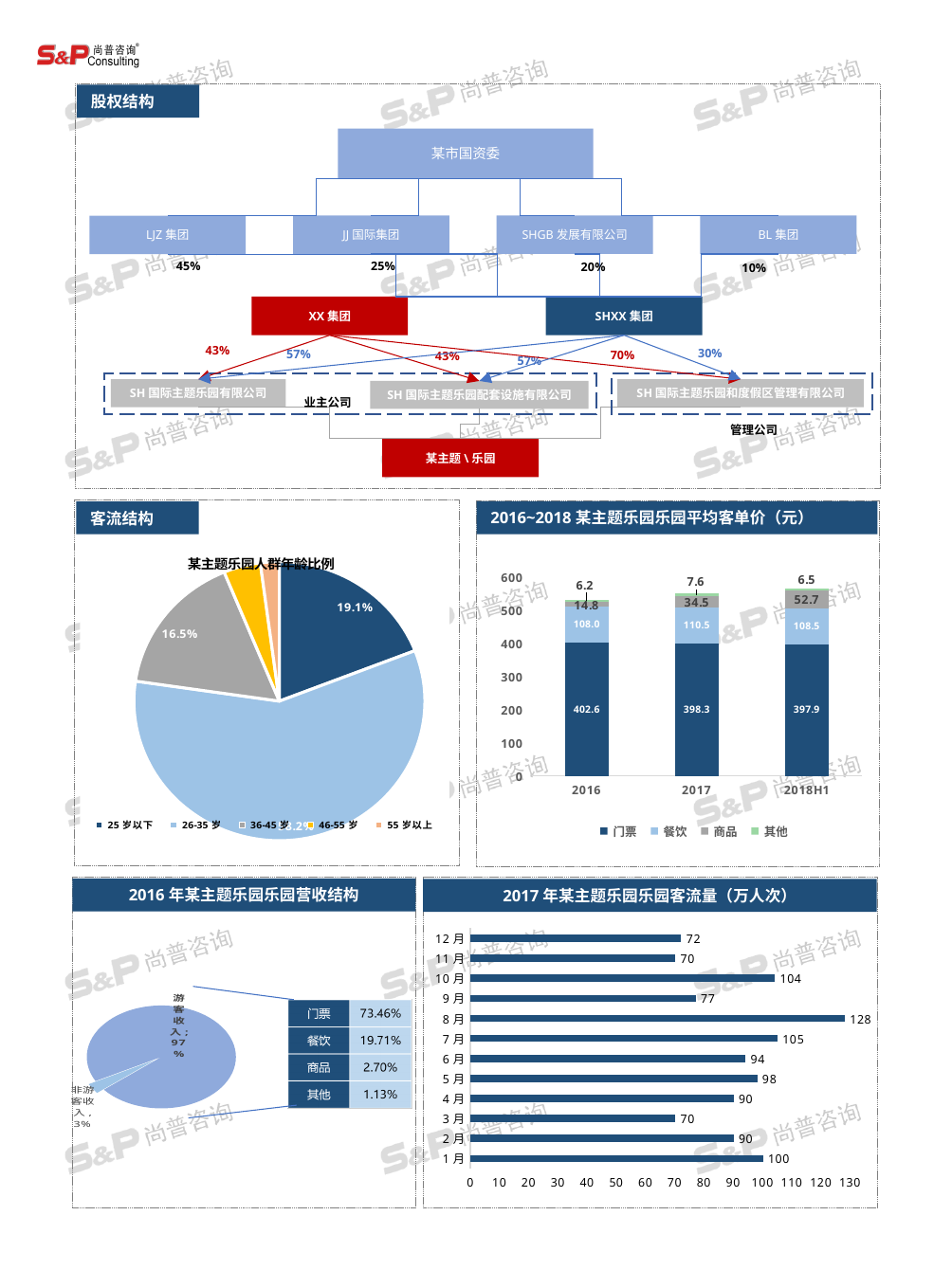
In the chart titled 2017年某主题乐园乐园客流量（万人次）, what is the difference between the values for 8月 and 9月? 51 What kind of chart is the one titled 2017年某主题乐园乐园客流量（万人次）? bar chart In the chart titled 2017年某主题乐园乐园客流量（万人次）, how many months are plotted? 12 In the chart titled 2017年某主题乐园乐园客流量（万人次）, which month has the highest value? 8月 In the chart titled 2017年某主题乐园乐园客流量（万人次）, which is larger, the value for 7月 or the value for 10月? 7月 In the chart titled 2016~2018 某主题乐园乐园平均客单价（元）, what is the 门票 value for 2017? 398.3 In the chart titled 2017年某主题乐园乐园客流量（万人次）, what is the value for 8月? 128 In the chart titled 2016~2018 某主题乐园乐园平均客单价（元）, how many series does the legend list? 4 In the chart titled 2016~2018 某主题乐园乐园平均客单价（元）, what is the total of the stacked bar for 2016? 531.6 In the chart titled 2016~2018 某主题乐园乐园平均客单价（元）, does the 商品 value rise or fall from 2016 to 2018H1? rise In the chart titled 2016年某主题乐园乐园营收结构, what is the value shown for 餐饮 in the table? 19.71% In the pie chart titled 某主题乐园人群年龄比例, what is the share for 25岁以下? 19.1%